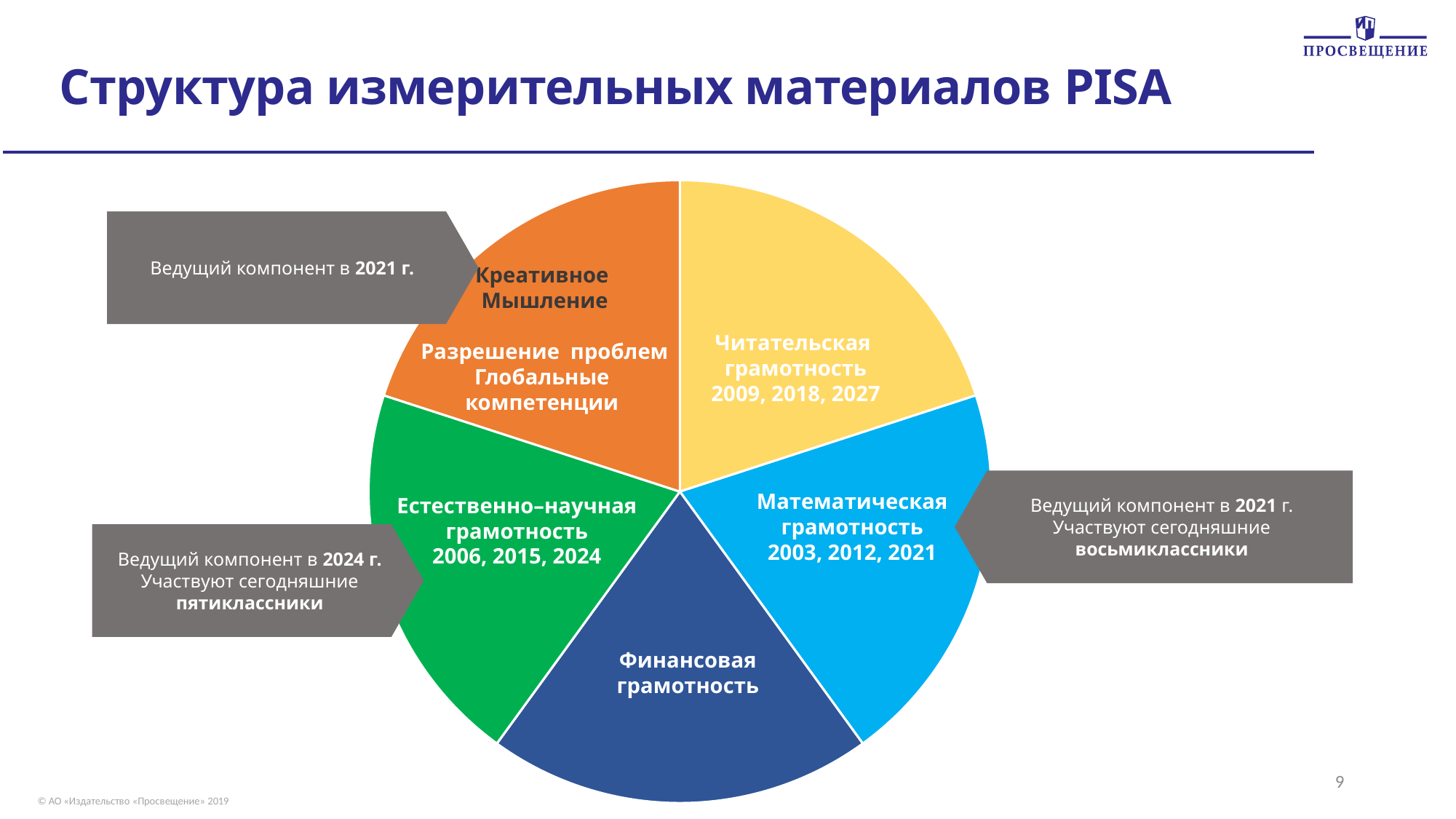
Which slice of the pie chart is coloured orange? Креативное мышление / Разрешение проблем / Глобальные компетенции Which years are printed on the Естественно-научная грамотность slice? 2006, 2015, 2024 What colour is the Финансовая грамотность slice? Dark blue Which slice is labelled with the years 2003, 2012, 2021? Математическая грамотность Which years are printed on the Математическая грамотность slice? 2003, 2012, 2021 How many slices does the pie chart have? 5 What kind of chart is shown on the slide? Pie chart Which years are printed on the Читательская грамотность slice? 2009, 2018, 2027